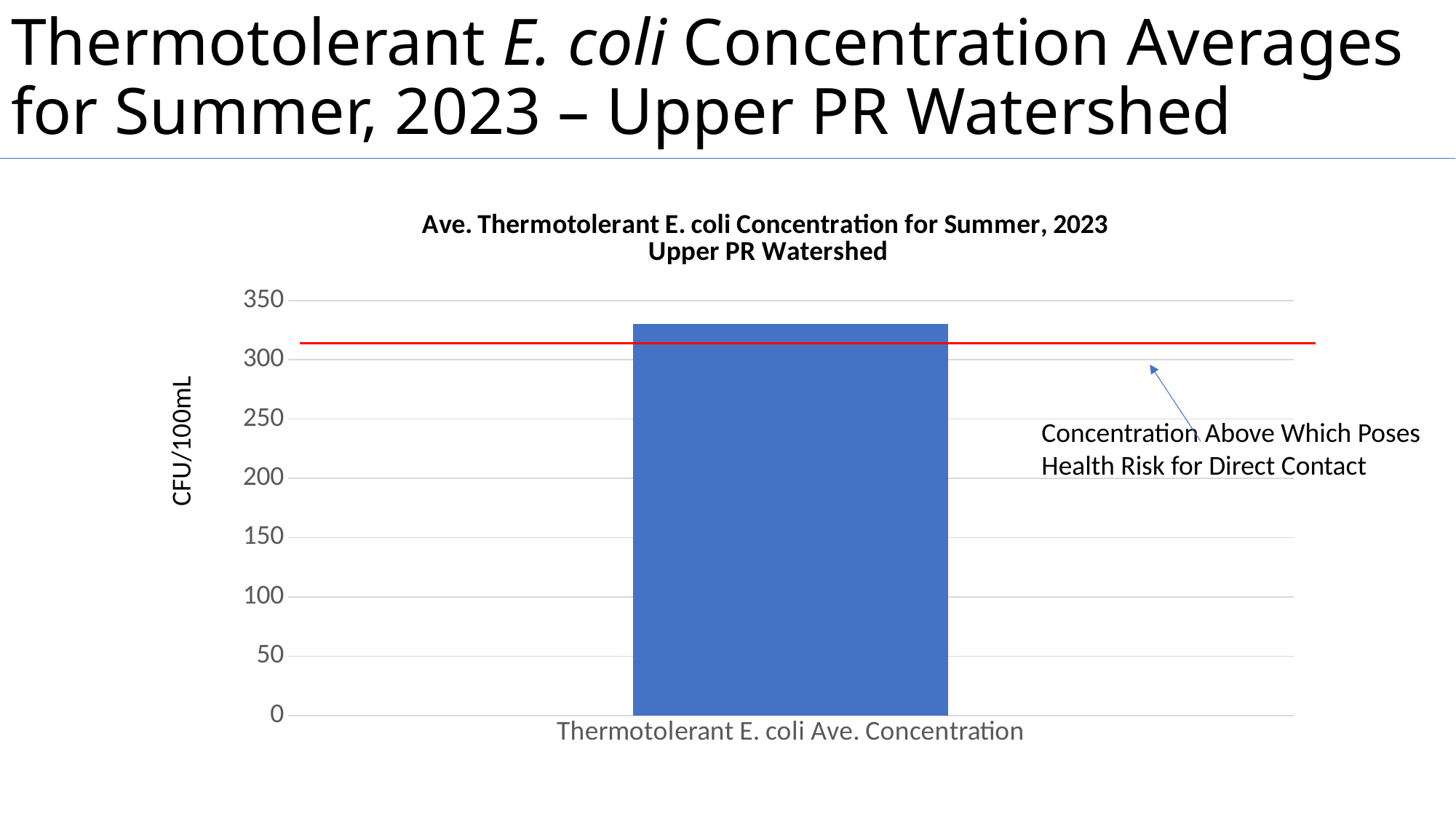
What unit is shown on the y-axis label of the chart? CFU/100mL Is the value for Thermotolerant E. coli Ave. Concentration greater or less than 300? greater What is the title of the chart? Ave. Thermotolerant E. coli Concentration for Summer, 2023 Upper PR Watershed What is the highest value shown on the y-axis of the chart? 350 What is the category label shown under the bar? Thermotolerant E. coli Ave. Concentration Is the value for Thermotolerant E. coli Ave. Concentration greater or less than 250? greater What kind of chart is shown on the slide? bar chart How many bars are plotted in the chart? 1 Does the bar extend above the red horizontal line on the chart? Yes Is the value for Thermotolerant E. coli Ave. Concentration greater or less than 350? less